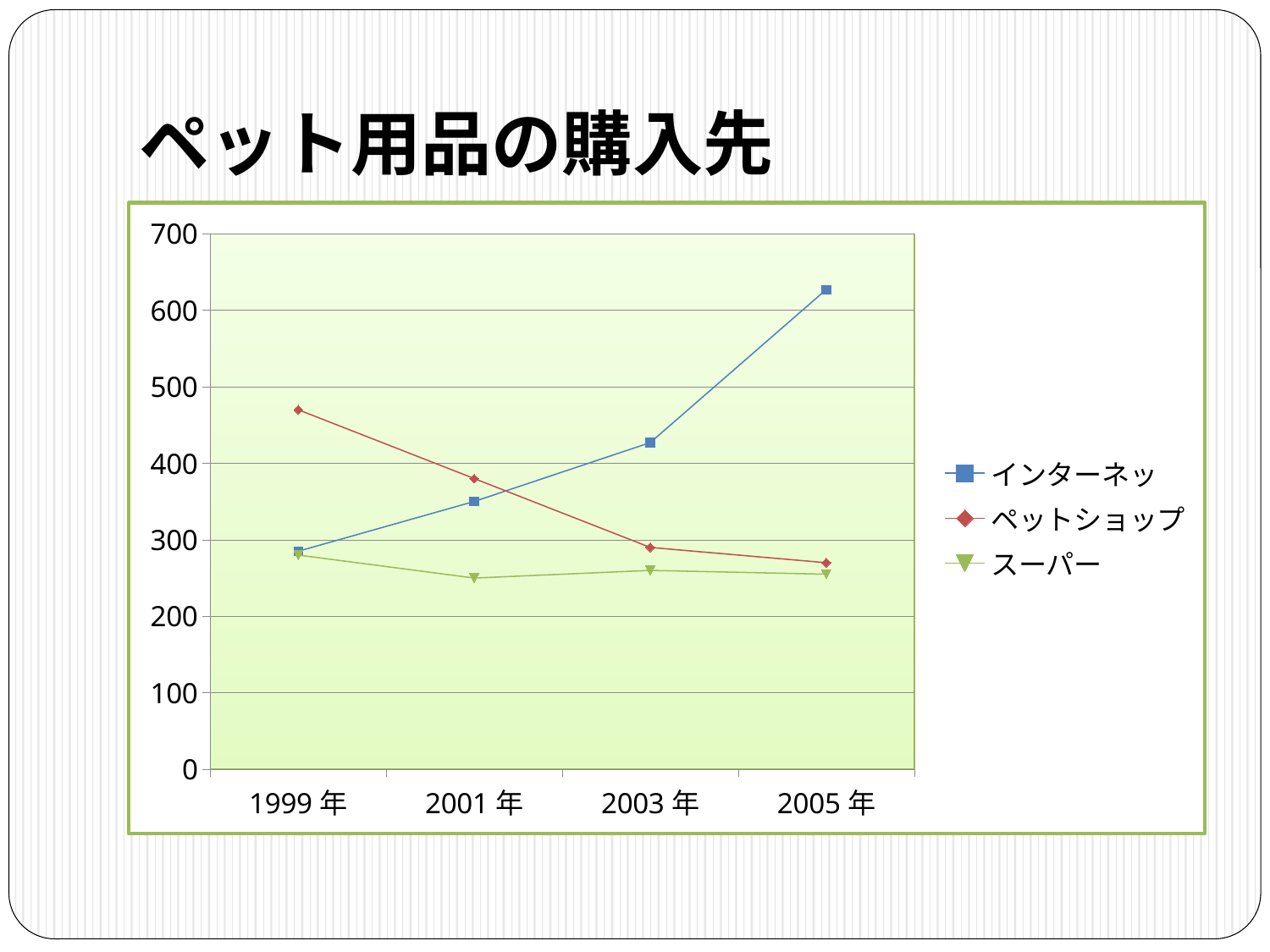
Is the value for ペットショップ in 1999年 greater or less than 400? greater How many years are plotted along the x axis? 4 Which series has the highest value in 1999年? ペットショップ Does the ペットショップ series rise or fall from 1999年 to 2005年? fall What is the title of the slide? ペット用品の購入先 What kind of chart is shown on the slide? line chart How many series does the legend list? 3 Is the value for インターネッ in 2005年 greater or less than 600? greater Which series has the lowest value in 2001年? スーパー Is the value for スーパー in 2001年 greater or less than 300? less Does the インターネッ series rise or fall from 1999年 to 2005年? rise Which series has the highest value in 2005年? インターネッ